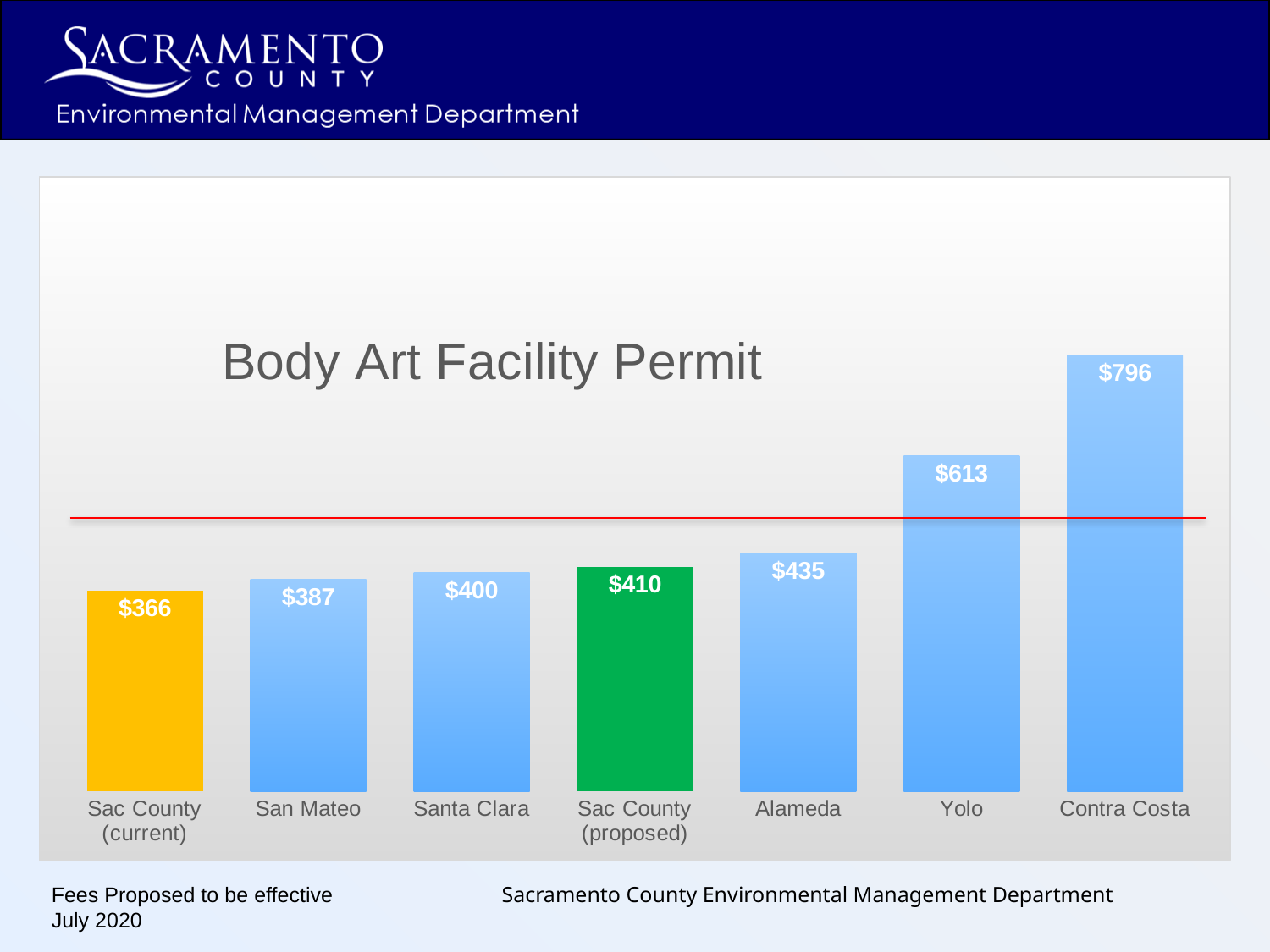
What is the Body Art Facility Permit fee for Sac County (proposed)? $410 Which county has the highest Body Art Facility Permit fee? Contra Costa What is the difference between the Sac County (proposed) fee and the Sac County (current) fee? $44 How many categories are shown in the Body Art Facility Permit chart? 7 What is the Body Art Facility Permit fee for Yolo? $613 Which category has the lowest Body Art Facility Permit fee? Sac County (current) Which is larger, the fee for San Mateo or the fee for Santa Clara? Santa Clara What is the Body Art Facility Permit fee for Alameda? $435 What is the Body Art Facility Permit fee for Sac County (current)? $366 What kind of chart is shown on the slide? Bar chart What is the difference between the Contra Costa fee and the Sac County (proposed) fee? $386 Which bar in the chart is coloured green? Sac County (proposed)